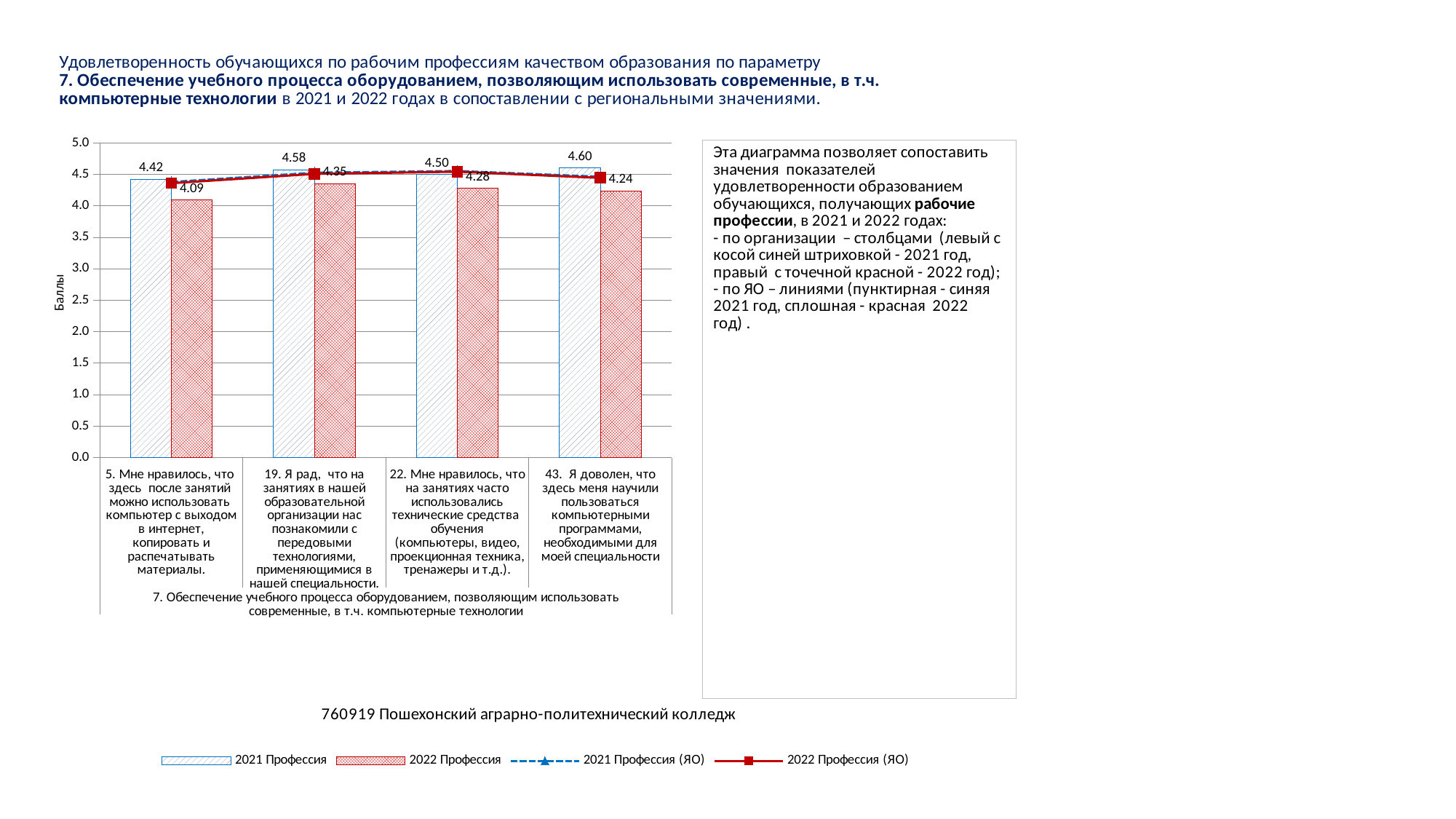
How many series does the chart legend list? 4 What is the 2022 Профессия value for category 43 (Я доволен, что здесь меня научили пользоваться компьютерными программами...)? 4.24 Is the 2022 Профессия value for category 5 greater or less than 4.5? less What kind of chart is used to show the 2021 Профессия and 2022 Профессия series? bar chart Which category has the lowest 2022 Профессия value? 5. Мне нравилось, что здесь после занятий можно использовать компьютер с выходом в интернет, копировать и распечатывать материалы. How many categories are shown on the x axis of the chart? 4 What is the 2022 Профессия value for category 19 (Я рад, что на занятиях в нашей образовательной организации нас познакомили с передовыми технологиями...)? 4.35 What is the label of the vertical axis of the chart? Баллы What is the difference between the 2021 Профессия and 2022 Профессия values for category 43? 0.36 For category 22, which is larger: the 2021 Профессия value or the 2022 Профессия value? 2021 Профессия What is the 2021 Профессия value for category 5 (Мне нравилось, что здесь после занятий можно использовать компьютер с выходом в интернет...)? 4.42 Which category has the highest 2021 Профессия value? 43. Я доволен, что здесь меня научили пользоваться компьютерными программами, необходимыми для моей специальности